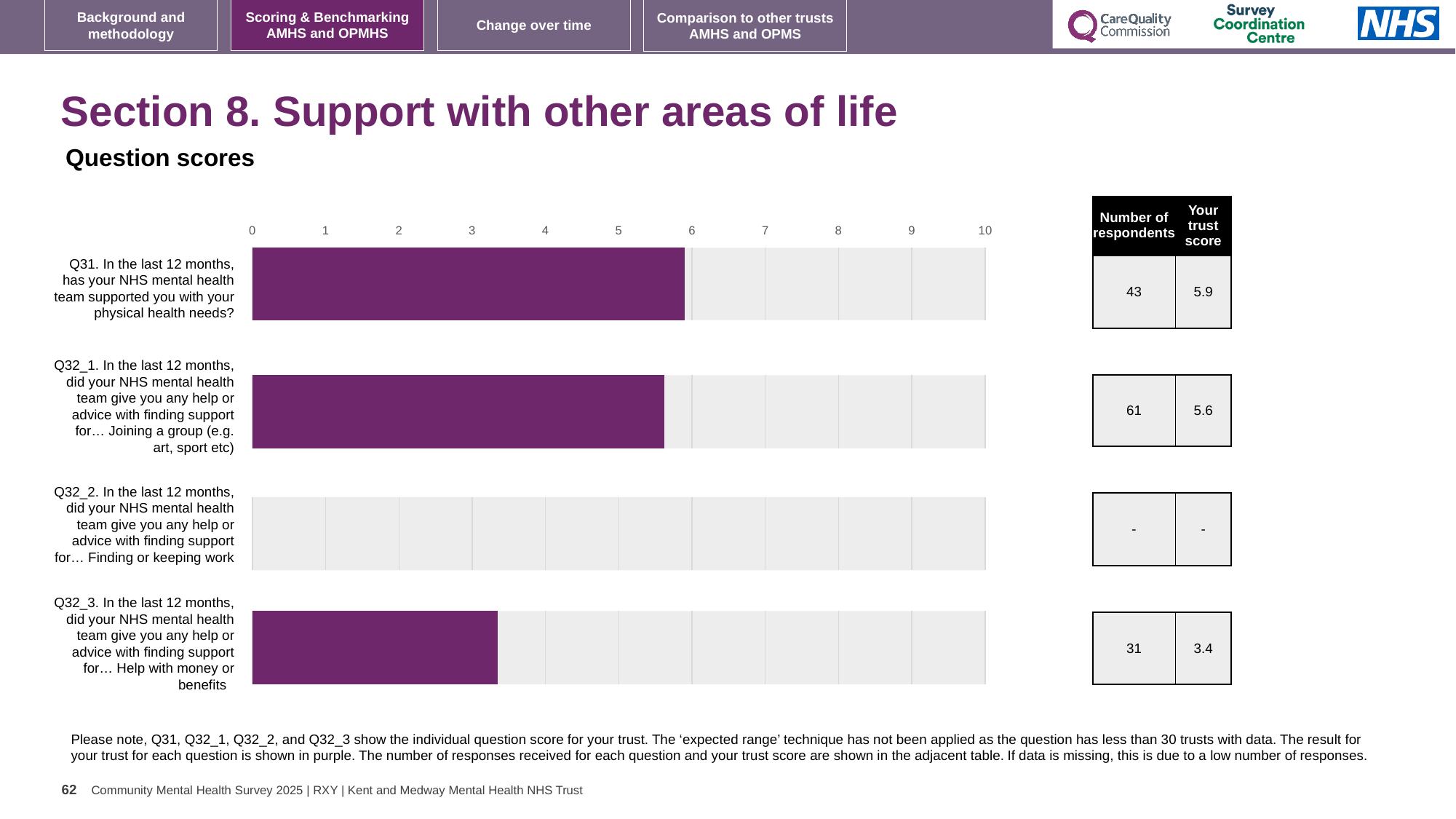
Which has the larger trust score, Q32_1 or Q32_3? Q32_1 What kind of chart is shown on the slide? Bar chart What is the trust score for Q32_3 (help with money or benefits)? 3.4 What is the trust score for Q31 (support with physical health needs)? 5.9 How many respondents answered Q32_1? 61 Which question with a score shown has the lowest trust score? Q32_3 Which question has no data shown (marked with a dash)? Q32_2 How many questions are listed on the chart? 4 Is the trust score for Q32_3 greater or less than 4? less What is the difference between the trust scores for Q31 and Q32_3? 2.5 Which question has the highest trust score? Q31 What is the trust score for Q32_1 (joining a group)? 5.6